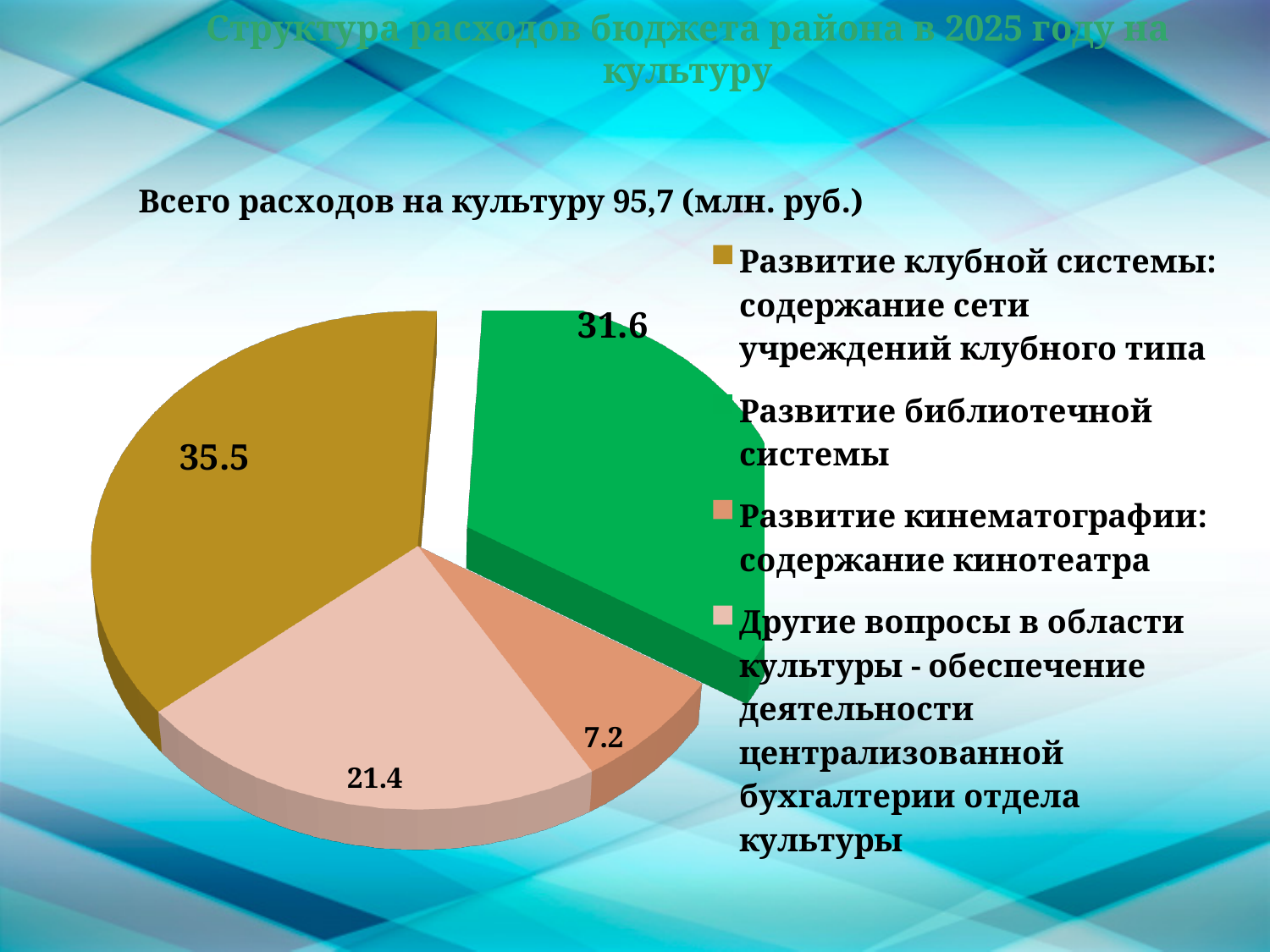
Which category has the largest slice of the pie? Развитие клубной системы: содержание сети учреждений клубного типа What total expenditure on culture is stated in the chart title? 95,7 (млн. руб.) How many slices does the pie chart have? 4 Which category has the smallest slice of the pie? Развитие кинематографии: содержание кинотеатра What is the value for "Развитие клубной системы: содержание сети учреждений клубного типа"? 35.5 What type of chart is shown on the slide? Pie chart What colour is the slice for "Развитие библиотечной системы"? Green Which is larger: the value for "Другие вопросы в области культуры" or the value for "Развитие кинематографии"? Другие вопросы в области культуры What is the difference between the values for "Развитие клубной системы" and "Развитие библиотечной системы"? 3.9 What is the value for "Развитие библиотечной системы"? 31.6 What is the value for "Развитие кинематографии: содержание кинотеатра"? 7.2 What is the value for "Другие вопросы в области культуры"? 21.4